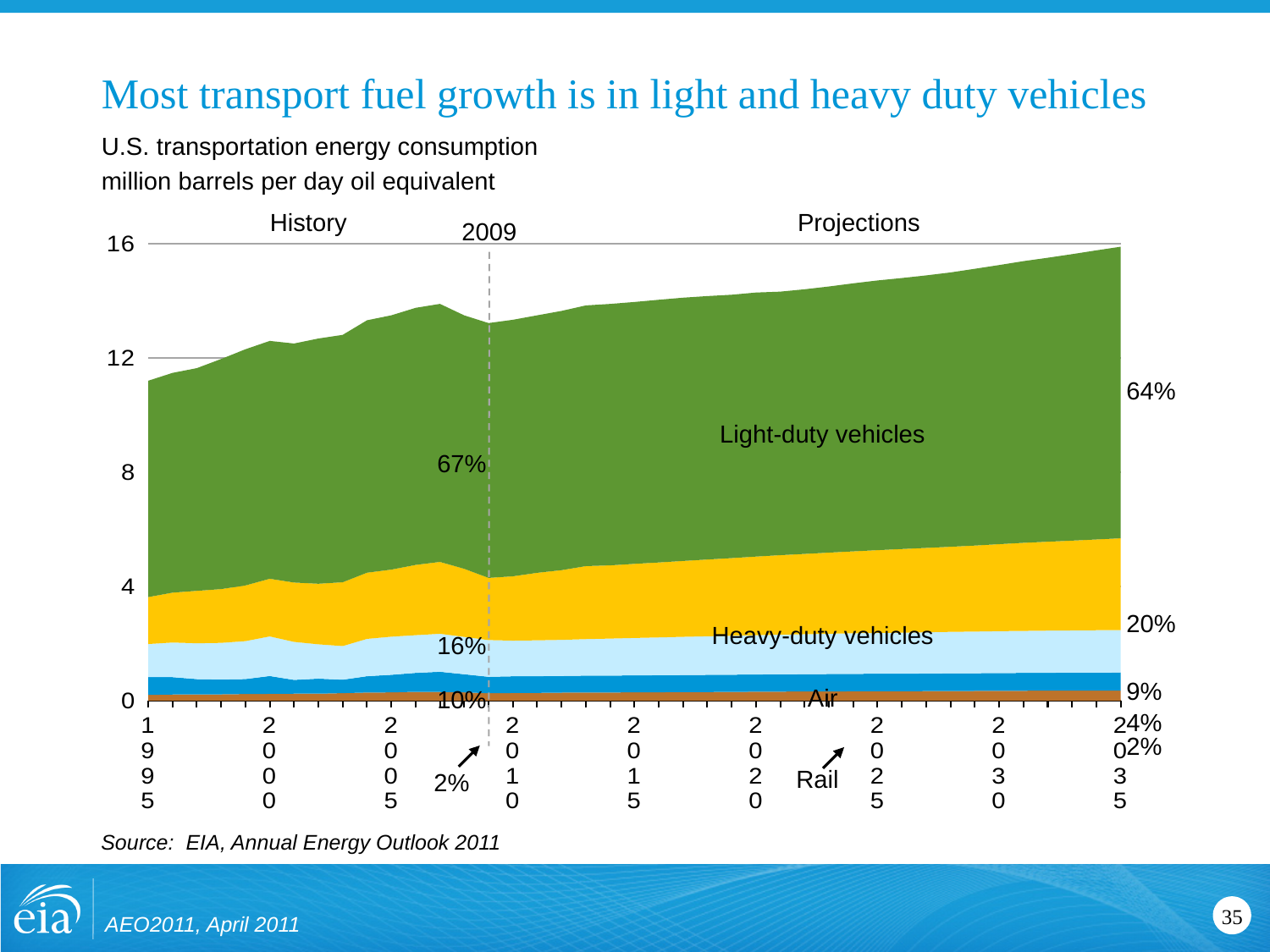
Which has the larger share of transportation energy consumption in 2009, light-duty vehicles or heavy-duty vehicles? Light-duty vehicles Which year does the dashed vertical line separating History from Projections mark? 2009 Does total transportation energy consumption rise or fall over the projection period from 2009 to 2035? Rise What kind of chart is shown on the slide? Stacked area chart What share does rail account for in 2009? 2% By how many percentage points does the heavy-duty vehicle share change between 2009 and 2035? 4 percentage points What share of U.S. transportation energy consumption do light-duty vehicles account for in 2009? 67% Is total U.S. transportation energy consumption in 2035 greater or less than 12 million barrels per day oil equivalent? greater What share does air transport account for in 2009? 10% What share of U.S. transportation energy consumption do light-duty vehicles account for in 2035? 64% What share do heavy-duty vehicles account for in 2035? 20% What share do heavy-duty vehicles account for in 2009? 16%